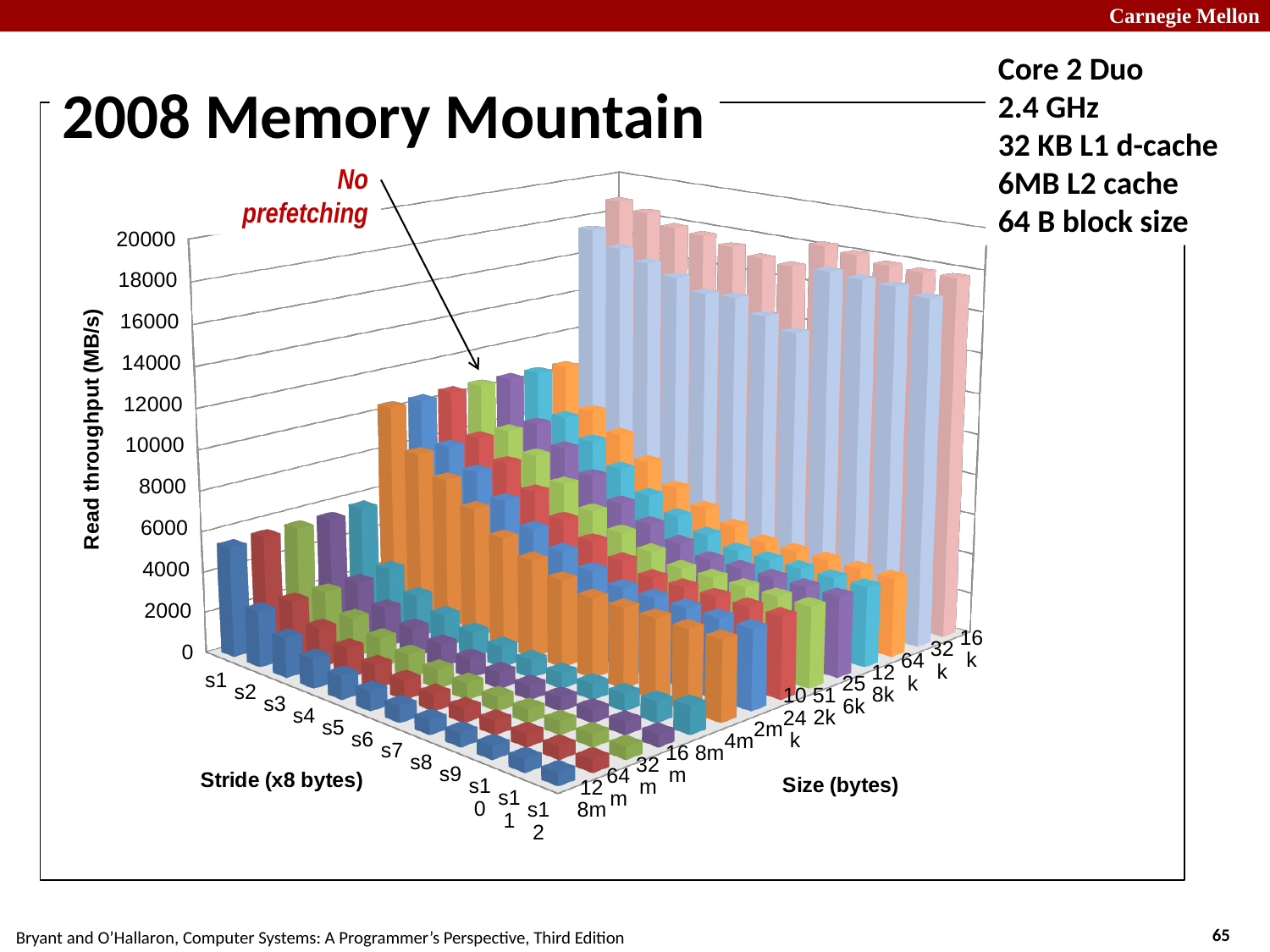
What is the label of the vertical axis of the chart? Read throughput (MB/s) Is the read throughput for stride s1 at size 8m greater or less than 4000? greater For size 8m, which stride has the highest read throughput? s1 How many size categories are shown on the Size (bytes) axis? 14 How many stride categories (s1 through s12) are shown on the stride axis? 12 At size 8m, which has the larger read throughput: stride s1 or stride s12? s1 Is the read throughput for stride s12 at size 8m greater or less than 2000? less What is the title of the chart on the slide? 2008 Memory Mountain For size 8m, does read throughput rise or fall as the stride increases from s1 to s12? fall Is the read throughput for stride s1 at size 16k greater or less than 16000? greater What is the highest tick value shown on the Read throughput axis? 20000 What kind of chart is shown on the slide? 3D bar chart